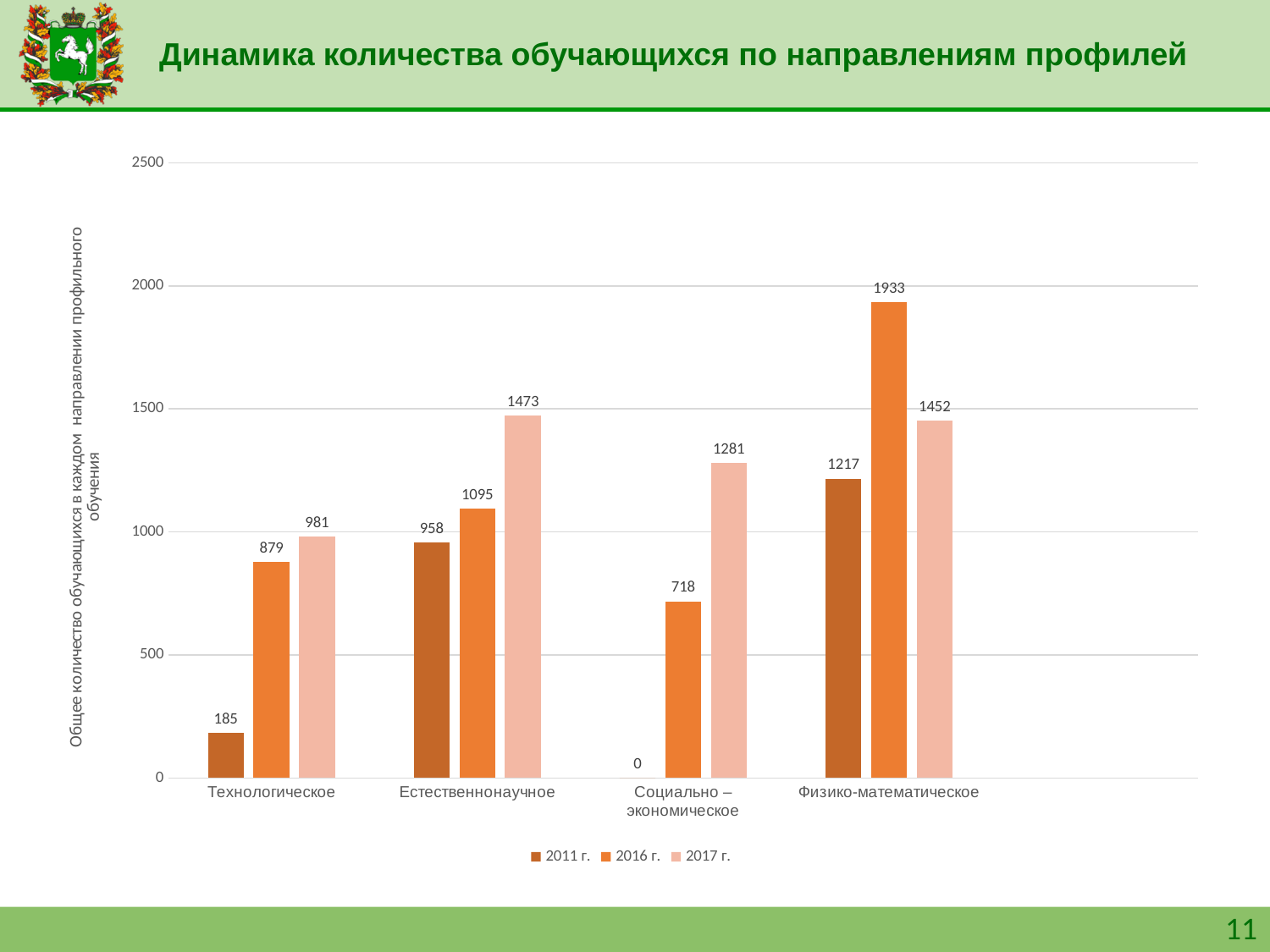
Which category has the highest value in the 2017 г. series? Естественнонаучное Do the values for Технологическое rise or fall from 2011 г. to 2017 г.? rise Which category has the lowest value in the 2016 г. series? Социально – экономическое How many series does the legend list? 3 What is the value for Естественнонаучное in the 2017 г. series? 1473 What kind of chart is shown on the slide? bar chart What is the difference between the 2016 г. and 2017 г. values for Физико-математическое? 481 What is the value for Технологическое in the 2011 г. series? 185 What is the value for Социально – экономическое in the 2011 г. series? 0 How many categories are shown on the x axis? 4 Which is larger: the 2011 г. value for Естественнонаучное or the 2011 г. value for Физико-математическое? Физико-математическое What is the value for Физико-математическое in the 2016 г. series? 1933